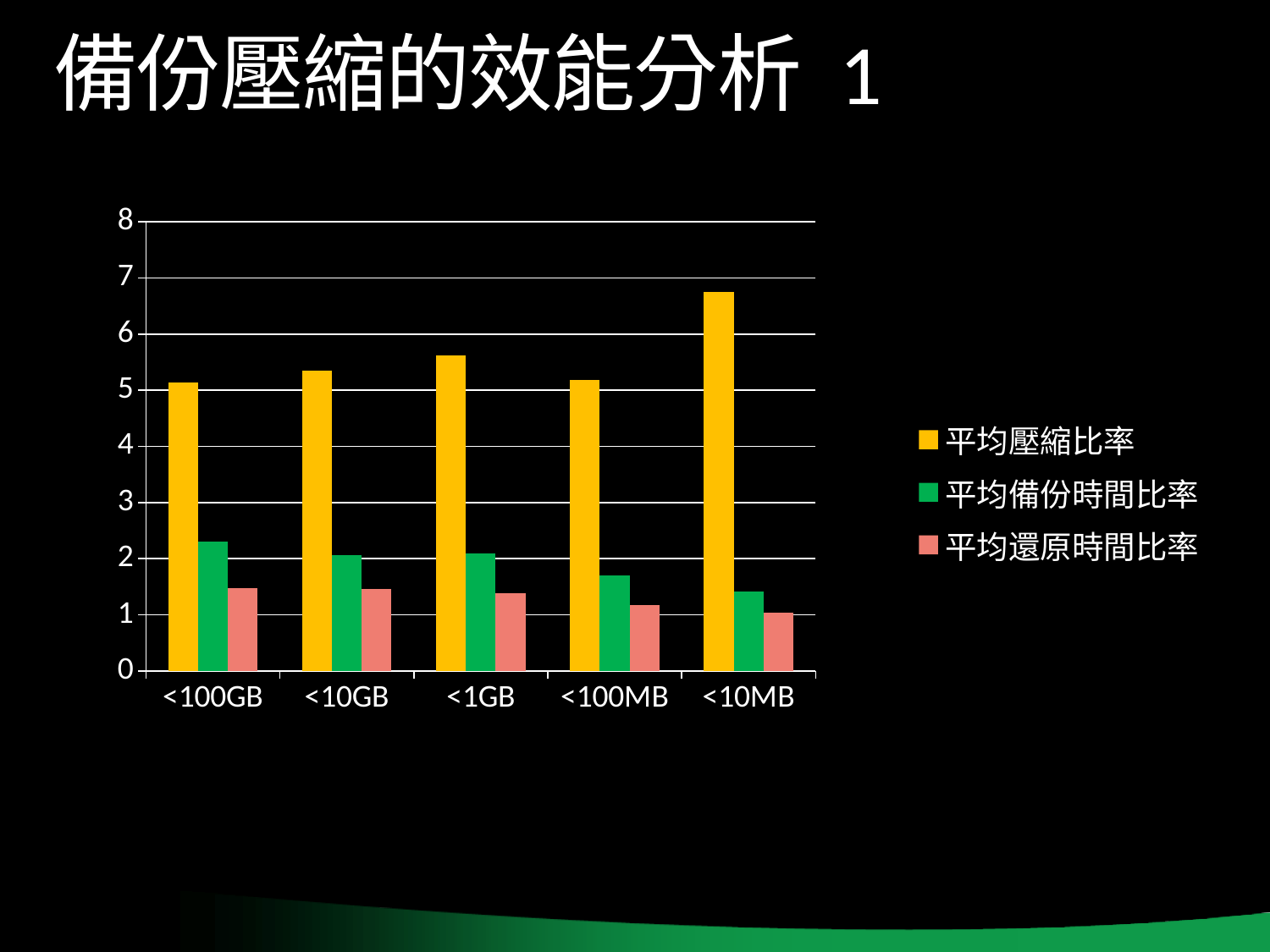
Is the 平均壓縮比率 for <1GB greater or less than 5? greater Is the 平均壓縮比率 for <10MB greater or less than 6? greater Which category has the lowest 平均還原時間比率? <10MB Which category has the highest 平均壓縮比率? <10MB Does the 平均還原時間比率 rise or fall from <100GB to <10MB along the x axis? fall How many categories are shown on the x axis? 5 How many series does the legend list? 3 Which category has the lowest 平均備份時間比率? <10MB Is the 平均備份時間比率 for <10MB greater or less than 2? less What kind of chart is shown on the slide? bar chart Which is larger for <100MB: 平均備份時間比率 or 平均還原時間比率? 平均備份時間比率